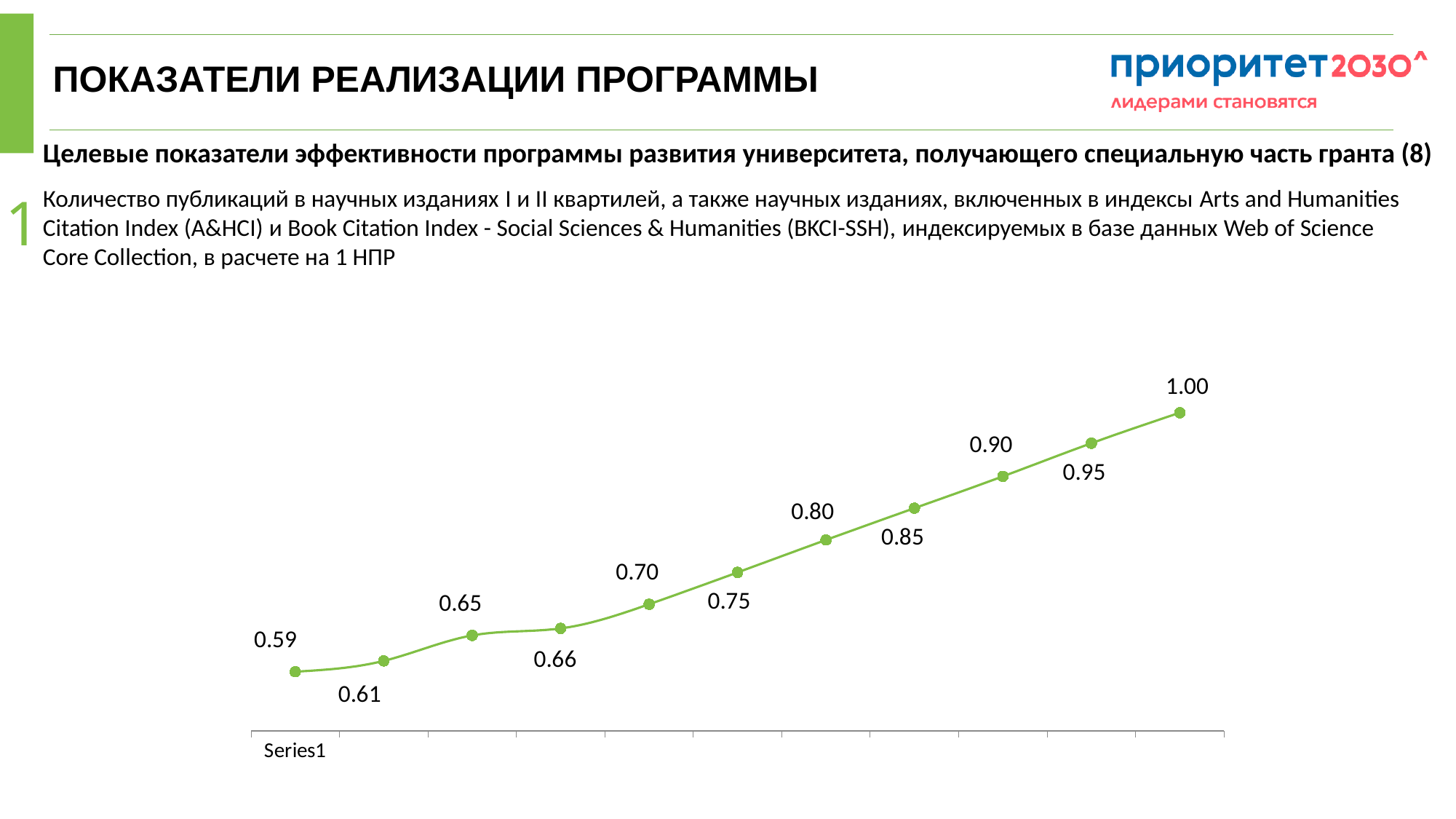
What kind of chart is shown on the slide? line chart What is the difference between the last point (1.00) and the first point (0.59)? 0.41 Which is larger, the value of the fifth point or the value of the sixth point? the sixth point (0.75) Do the values rise or fall from left to right along the x axis? rise How many data points are plotted on the line? 11 What is the value of the first (leftmost) point on the line? 0.59 What is the value of the fourth point from the left? 0.66 What is the value of the last (rightmost) point on the line? 1.00 What is the highest value plotted on the chart? 1.00 What is the lowest value plotted on the chart? 0.59 What is the difference between the third point (0.65) and the second point (0.61)? 0.04 What label is shown on the x axis under the first point? Series1